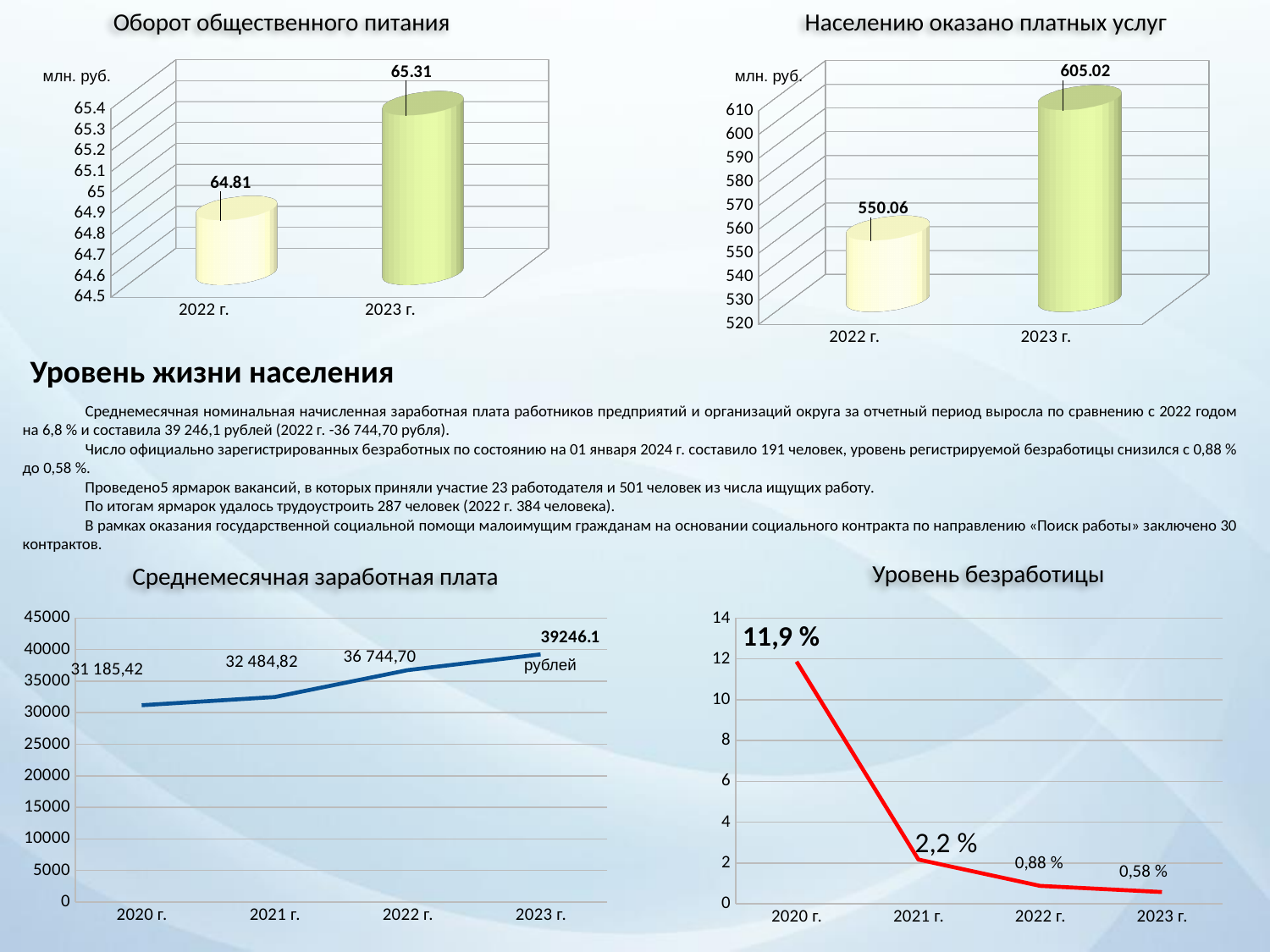
In the chart 'Среднемесячная заработная плата', what is the value for 2022 г.? 36 744,70 In the chart 'Среднемесячная заработная плата', do the values rise or fall from 2020 г. to 2023 г.? rise In the chart 'Населению оказано платных услуг', what is the difference between the 2023 г. and 2022 г. values? 54.96 How many years are plotted in the chart 'Уровень безработицы'? 4 What kind of chart is 'Оборот общественного питания'? bar chart In the chart 'Оборот общественного питания', what is the value for 2023 г.? 65.31 In the chart 'Среднемесячная заработная плата', what is the value for 2020 г.? 31 185,42 In the chart 'Оборот общественного питания', what is the value for 2022 г.? 64.81 In the chart 'Населению оказано платных услуг', what is the value for 2023 г.? 605.02 In the chart 'Уровень безработицы', which year has the lowest value? 2023 г. In the chart 'Уровень безработицы', what is the value for 2020 г.? 11,9 % In the chart 'Населению оказано платных услуг', which year has the higher value? 2023 г.